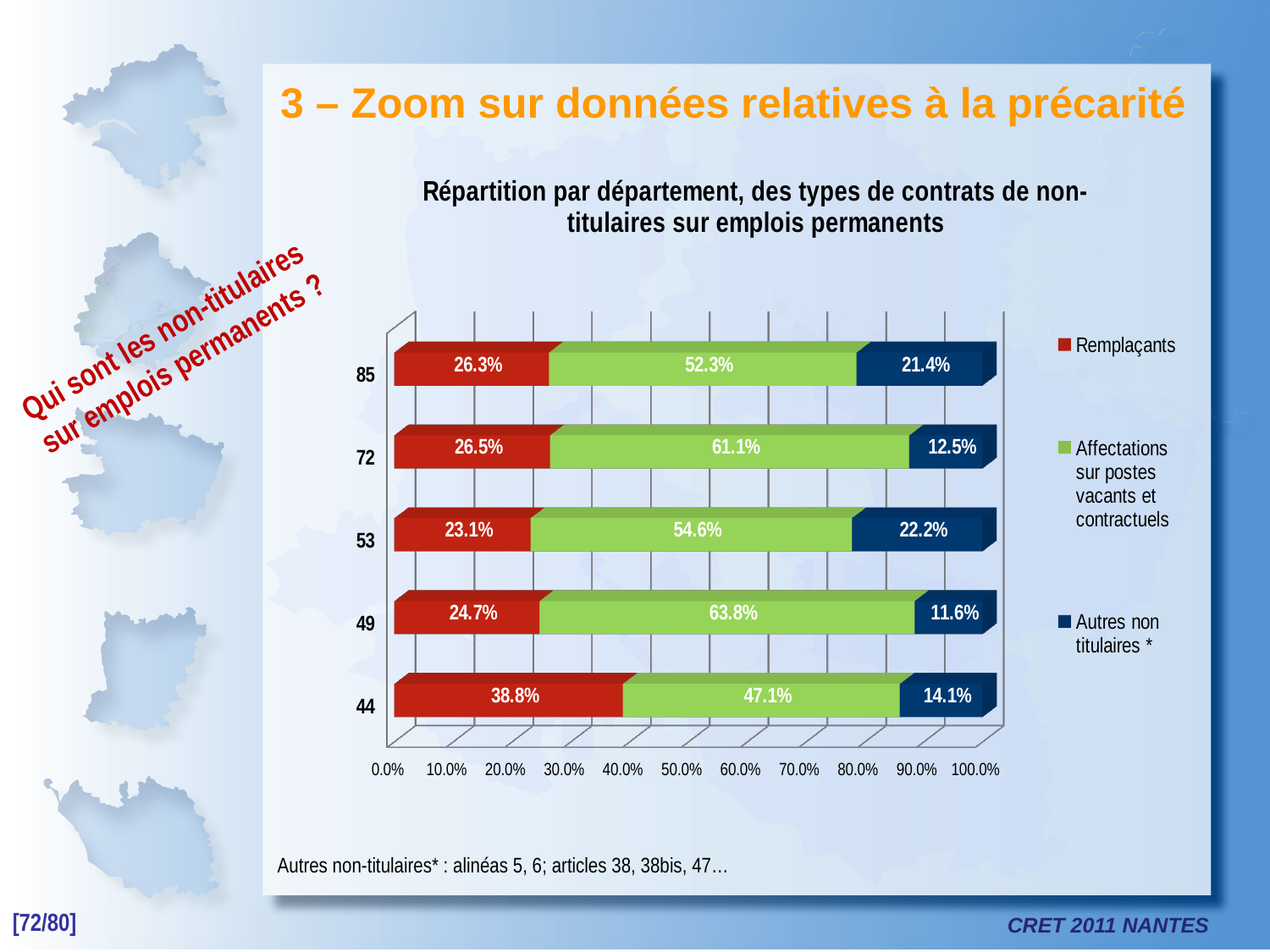
For department 72, what is the difference between the Affectations sur postes vacants et contractuels value and the Autres non titulaires value? 48.6 percentage points What is the value for Autres non titulaires for department 53? 22.2% Which department has the highest share of Remplaçants? 44 What kind of chart is shown on the slide? Stacked bar chart Which department has the larger Remplaçants share, 72 or 53? 72 Which department has the lowest share of Autres non titulaires? 49 What is the value for Affectations sur postes vacants et contractuels for department 49? 63.8% What is the total of the stacked bar for department 44? 100.0% What is the value for Remplaçants for department 44? 38.8% Which colour represents Remplaçants in the legend? Red How many departments are shown on the chart? 5 How many series does the legend list? 3